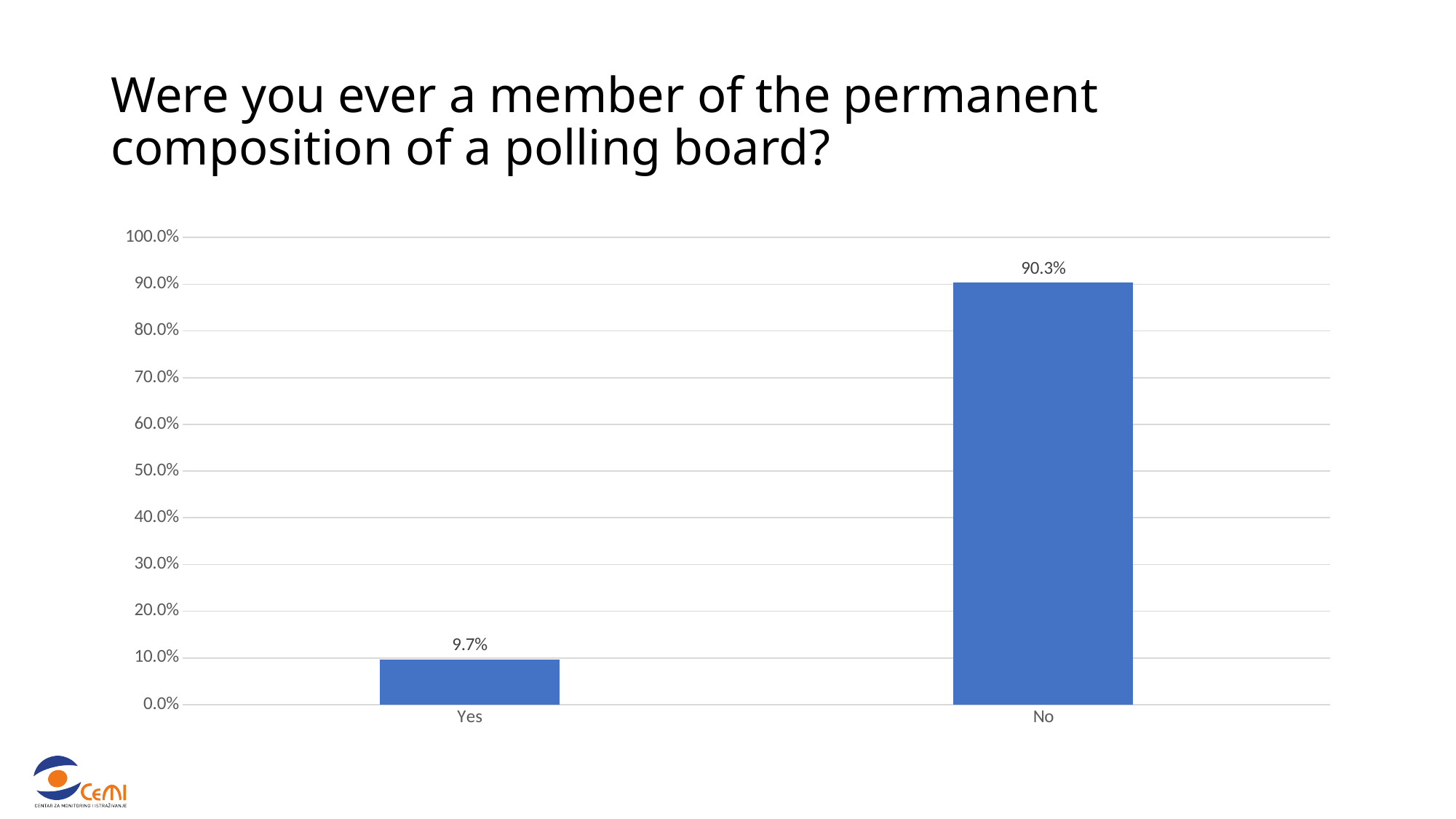
Which is larger, the value for Yes or the value for No? No Is the value for No greater or less than 80.0%? greater What is the difference between the No and Yes values? 80.6% What percentage of respondents answered Yes? 9.7% How many categories are shown on the x axis? 2 What is the title of the slide? Were you ever a member of the permanent composition of a polling board? What is the highest value shown on the y axis? 100.0% Is the value for Yes greater or less than 20.0%? less Which category has the lowest value? Yes Which category has the highest value? No What kind of chart is shown on the slide? bar chart What percentage of respondents answered No? 90.3%